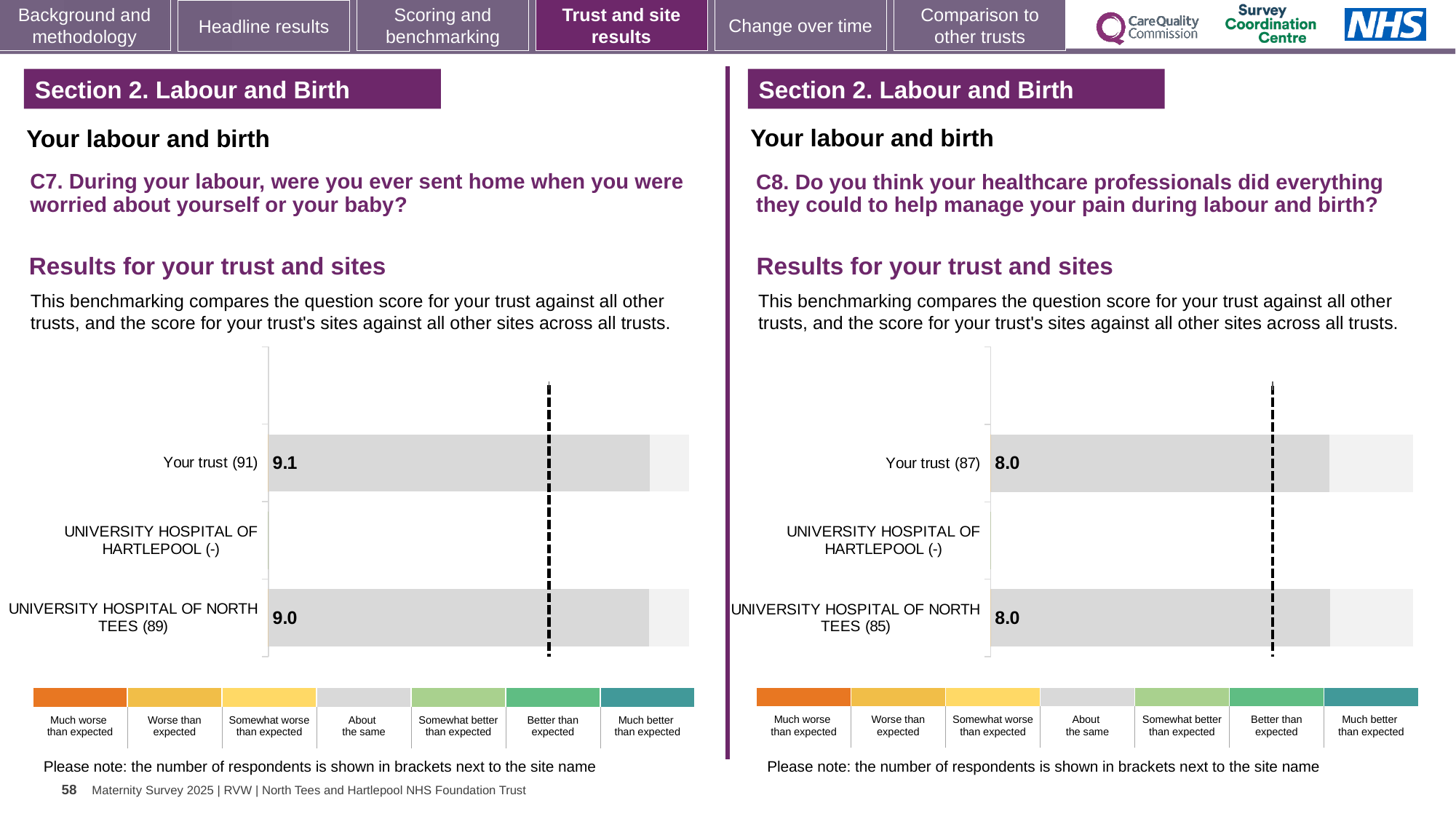
In the C7 chart on the left, what is the score for University Hospital of North Tees? 9.0 In the C7 chart on the left, how many respondents are shown in brackets for Your trust? 91 How many categories are listed on the y axis of the C7 chart on the left? 3 In the C7 chart on the left, what is the difference between the score for Your trust and the score for University Hospital of North Tees? 0.1 In the C8 chart on the right, what is the score for University Hospital of North Tees? 8.0 In the C8 chart on the right, which category has no bar plotted? University Hospital of Hartlepool (-) In the C8 chart on the right, what is the score for Your trust? 8.0 What kind of chart is the C8 chart on the right? Bar chart In the C7 chart on the left, what is the score for Your trust? 9.1 In the C7 chart on the left, which has the higher score, Your trust or University Hospital of North Tees? Your trust In the C8 chart on the right, which has the higher score, Your trust or University Hospital of North Tees? They are equal In the C8 chart on the right, how many respondents are shown in brackets for University Hospital of North Tees? 85